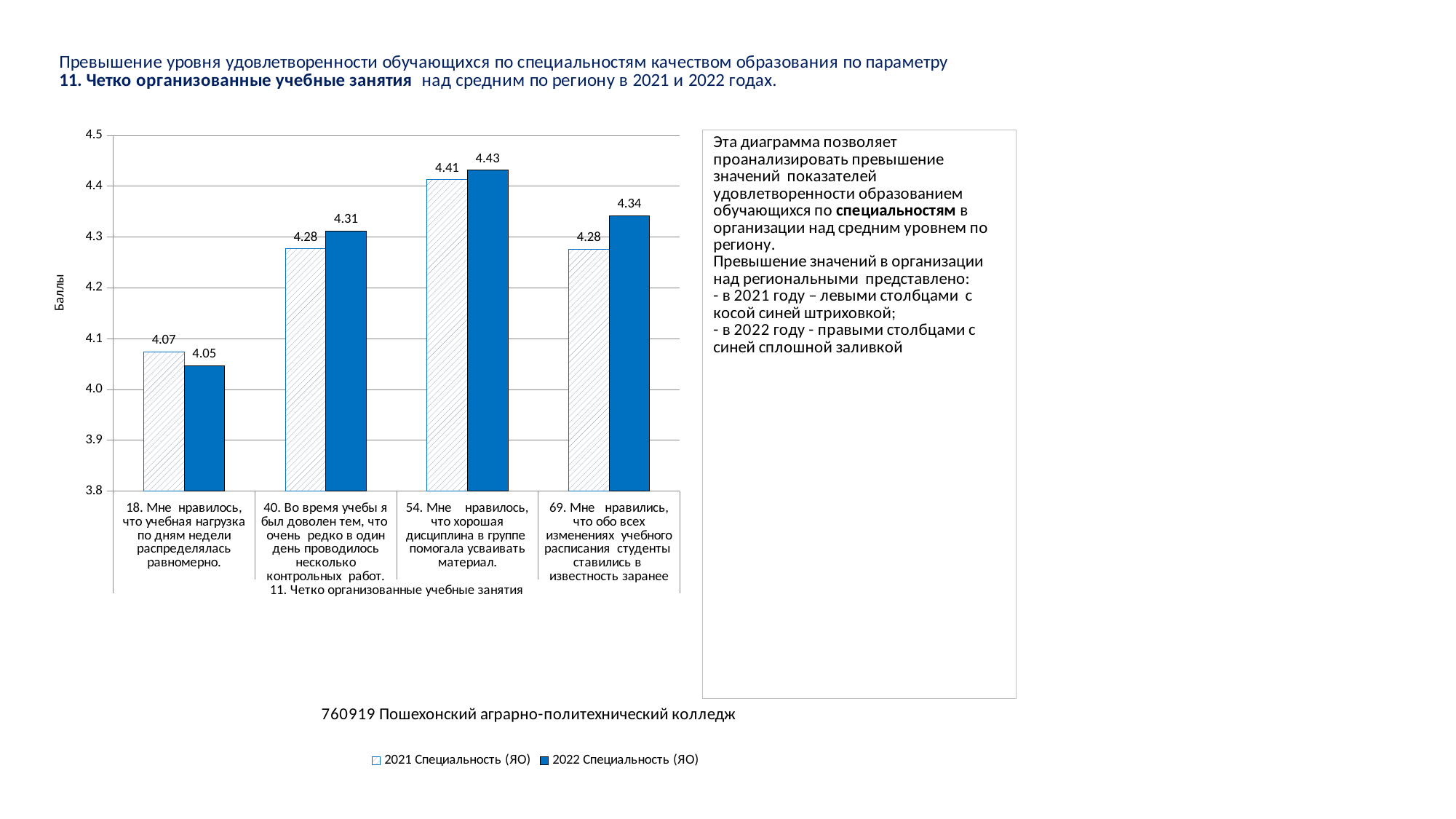
What is the difference between the 2021 values for category 54 and category 18? 0.34 What is the 2022 Специальность (ЯО) value for category 69 (Мне нравились, что обо всех изменениях учебного расписания студенты ставились в известность заранее)? 4.34 What is the 2021 Специальность (ЯО) value for category 18 (Мне нравилось, что учебная нагрузка по дням недели распределялась равномерно)? 4.07 Which category has the highest 2022 Специальность (ЯО) value? 54. Мне нравилось, что хорошая дисциплина в группе помогала усваивать материал. How many categories are shown on the x axis of the chart? 4 What type of chart is shown on the slide? Bar chart Is the 2022 value for category 40 greater or less than 4.2? greater Which category has the lowest 2021 Специальность (ЯО) value? 18. Мне нравилось, что учебная нагрузка по дням недели распределялась равномерно. For category 18, which is larger: the 2021 value or the 2022 value? 2021 value (4.07) What is the 2022 Специальность (ЯО) value for category 54 (Мне нравилось, что хорошая дисциплина в группе помогала усваивать материал)? 4.43 How many series does the legend list? 2 What is the difference between the 2022 and 2021 values for category 69? 0.06